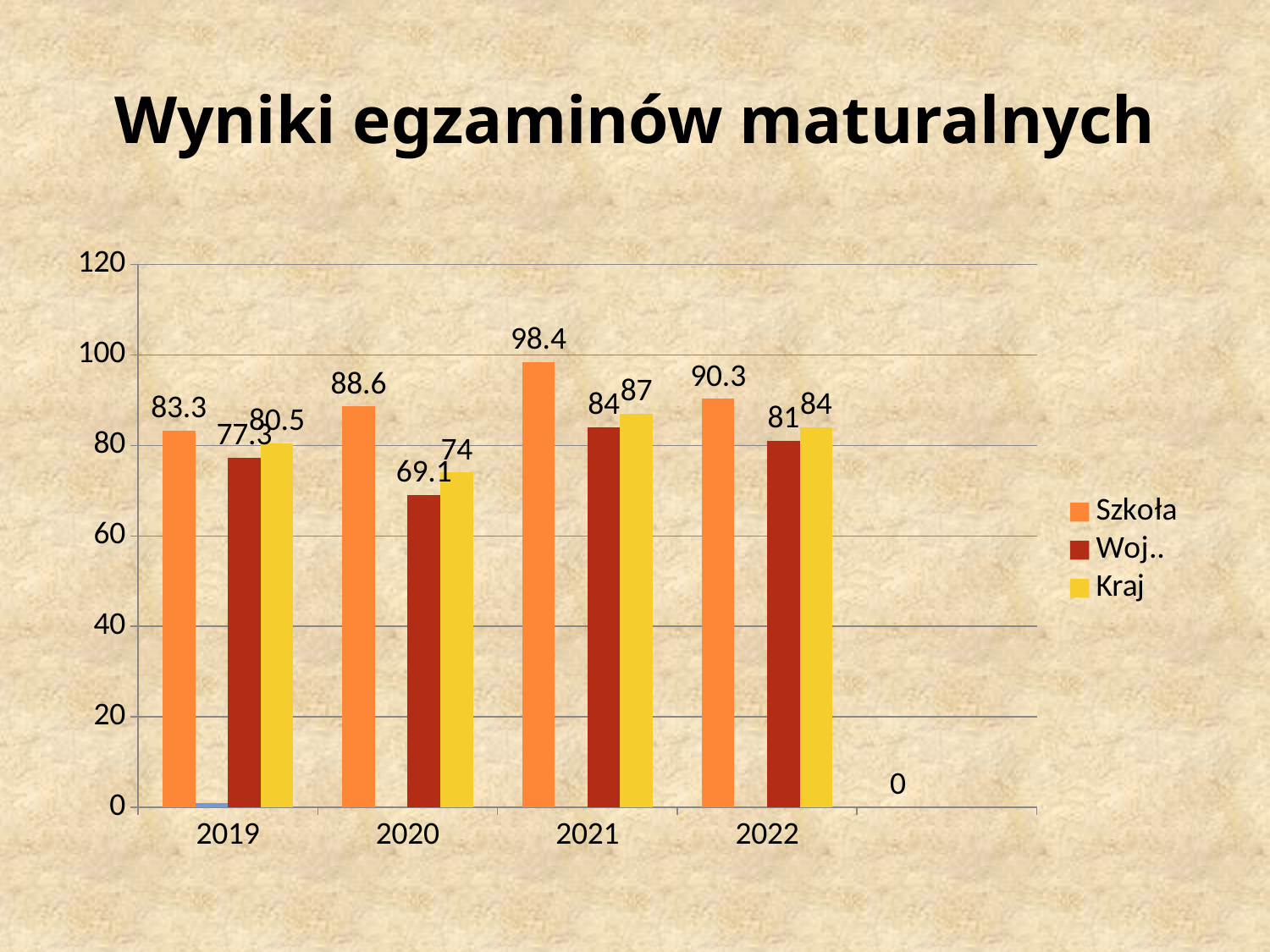
What is the value for Szkoła in 2021? 98.4 Does the Szkoła value rise or fall from 2019 to 2021? Rises In which year is the Woj.. value lowest? 2020 What is the value for Woj.. in 2020? 69.1 What kind of chart is shown on the slide? Bar chart Which is larger in 2022, the Szkoła value or the Kraj value? Szkoła In which year is the Szkoła value highest? 2021 What is the difference between the Kraj and Woj.. values in 2019? 3.2 What is the value for Kraj in 2019? 80.5 How many series does the legend list? 3 What is the title of the chart? Wyniki egzaminów maturalnych What is the difference between the Szkoła values for 2021 and 2020? 9.8